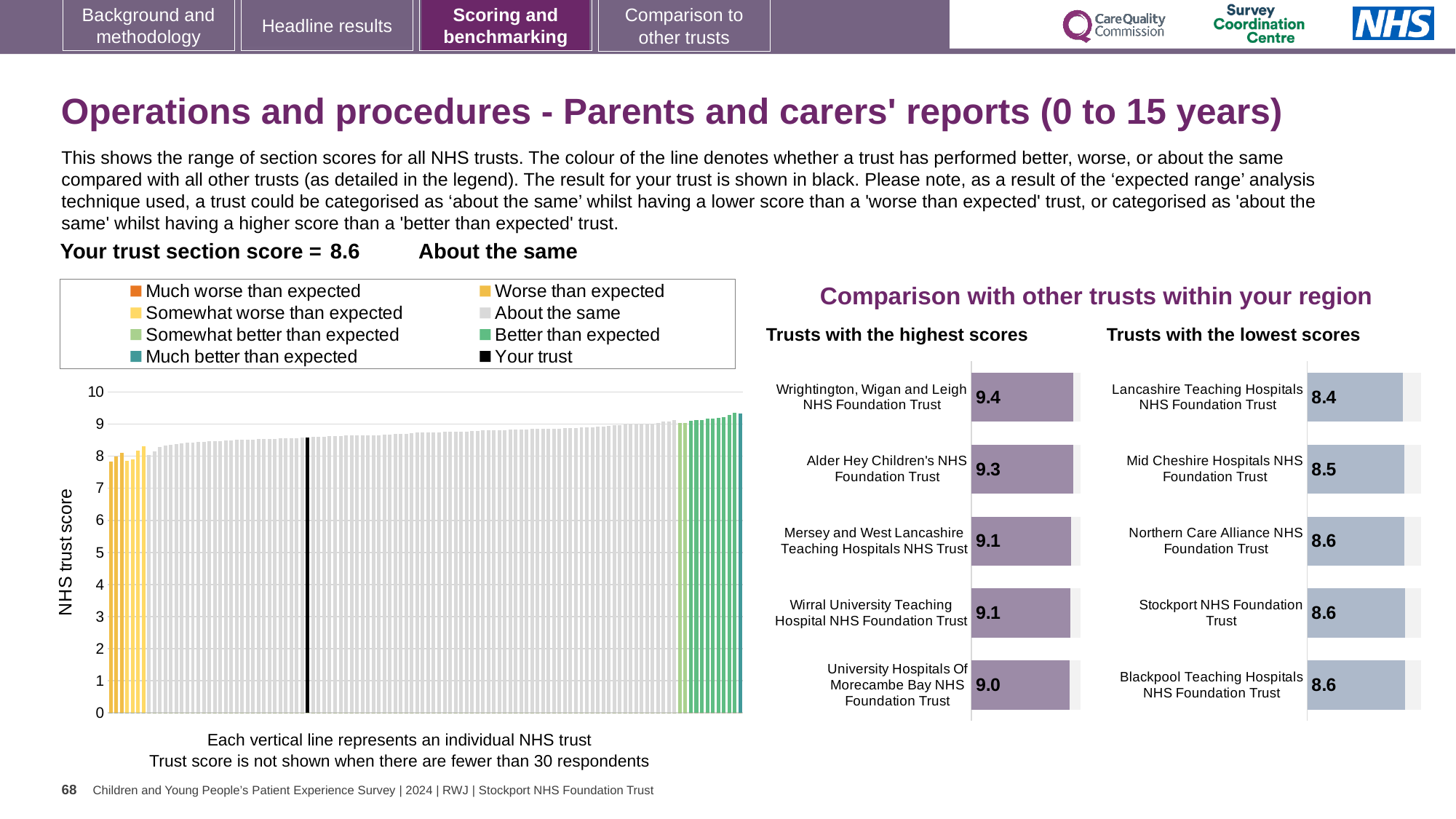
In the 'Trusts with the highest scores' chart, what is the difference between the scores of Wrightington, Wigan and Leigh NHS Foundation Trust and University Hospitals Of Morecambe Bay NHS Foundation Trust? 0.4 Comparing the two regional charts, which has the higher score: Alder Hey Children's NHS Foundation Trust or Mid Cheshire Hospitals NHS Foundation Trust? Alder Hey Children's NHS Foundation Trust In the 'Trusts with the lowest scores' chart, what is the score for Lancashire Teaching Hospitals NHS Foundation Trust? 8.4 What is the section score for your trust shown on the slide? 8.6 In the 'Trusts with the highest scores' chart, which trust has the highest score? Wrightington, Wigan and Leigh NHS Foundation Trust What kind of chart is the large chart on the left showing NHS trust scores? Bar chart In the 'Trusts with the highest scores' chart, what is the score for Wrightington, Wigan and Leigh NHS Foundation Trust? 9.4 In the 'Trusts with the lowest scores' chart, what is the score for Stockport NHS Foundation Trust? 8.6 How many entries does the legend of the left-hand chart list? 8 In the 'Trusts with the lowest scores' chart, which trust has the lowest score? Lancashire Teaching Hospitals NHS Foundation Trust How many trusts are shown in the 'Trusts with the highest scores' chart? 5 What is the title of the section containing the two small bar charts on the right of the slide? Comparison with other trusts within your region